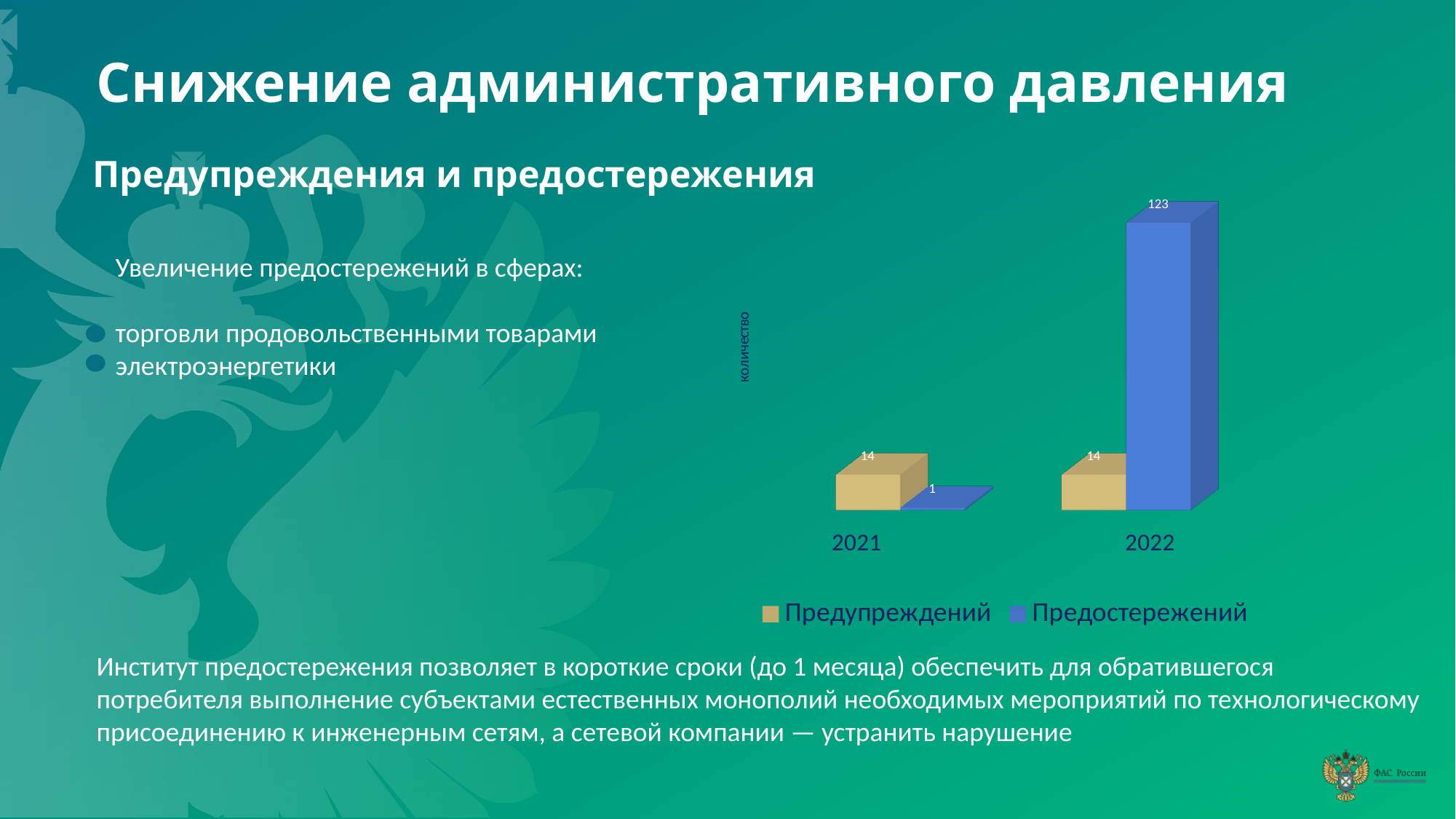
How many series does the chart legend list? 2 What was the number of Предупреждений in 2021? 14 What was the number of Предупреждений in 2022? 14 By how much did the number of Предостережений increase from 2021 to 2022? 122 What is the label on the vertical axis of the chart? количество What was the number of Предостережений in 2022? 123 What was the number of Предостережений in 2021? 1 How many years are shown on the x axis of the chart? 2 What kind of chart is shown on the slide? Bar chart In 2021, which was larger: Предупреждений or Предостережений? Предупреждений In 2022, which was larger: Предупреждений or Предостережений? Предостережений In which year was the number of Предостережений highest? 2022